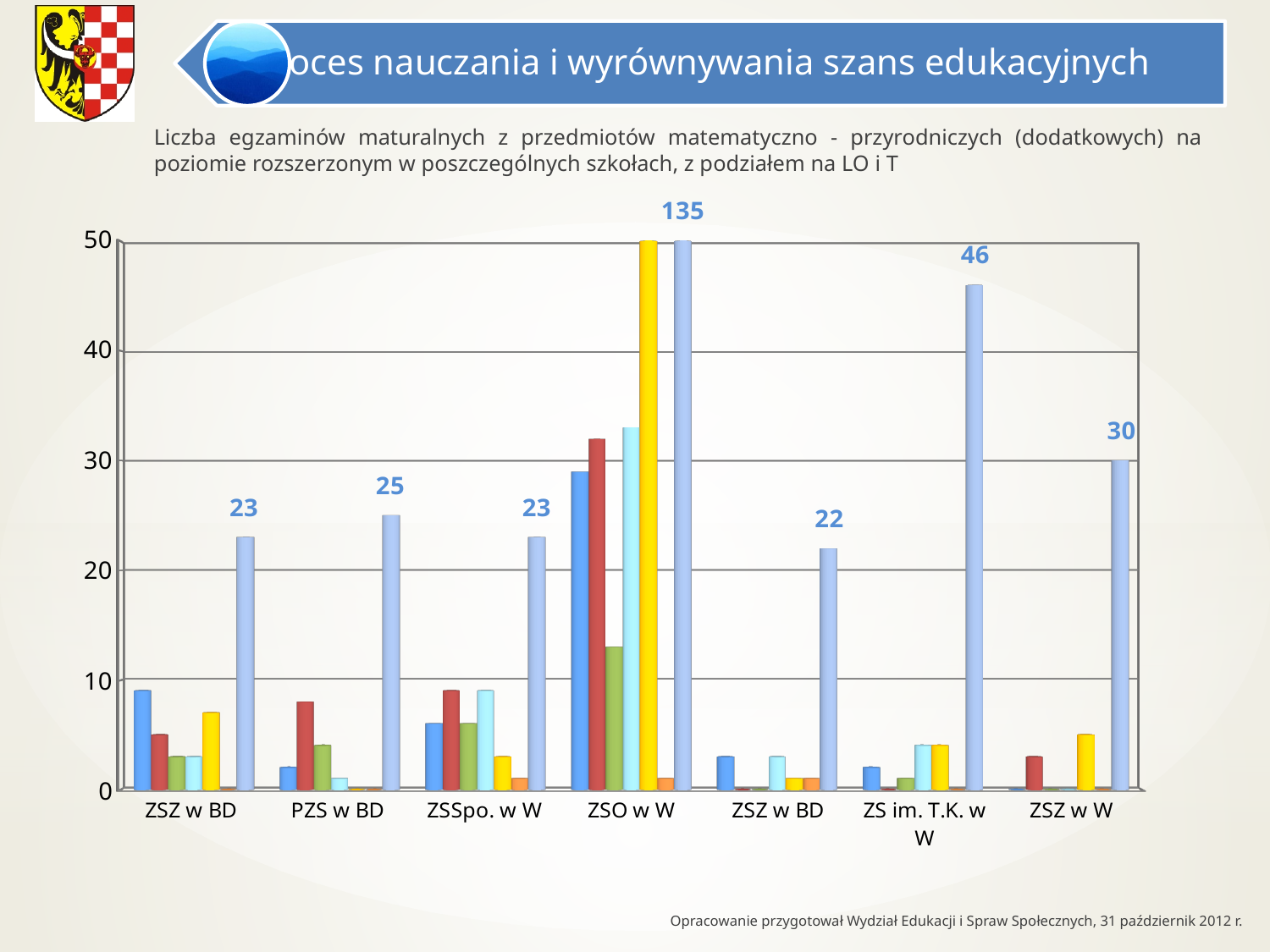
How many school categories are shown on the x axis of the chart? 7 What is the lowest labelled value shown on the chart? 22 Which has the larger labelled value, PZS w BD or ZSZ w W? ZSZ w W What is the highest value shown on the vertical axis of the chart? 50 What is the difference between the labelled values for ZS im. T.K. w W and ZSZ w W? 16 What is the labelled value for ZS im. T.K. w W? 46 What is the labelled value for ZSSpo. w W? 23 What is the labelled value for PZS w BD? 25 What is the labelled value for ZSZ w W? 30 What is the labelled value for ZSO w W? 135 Which school has the highest labelled value on the chart? ZSO w W What kind of chart is shown on the slide? bar chart